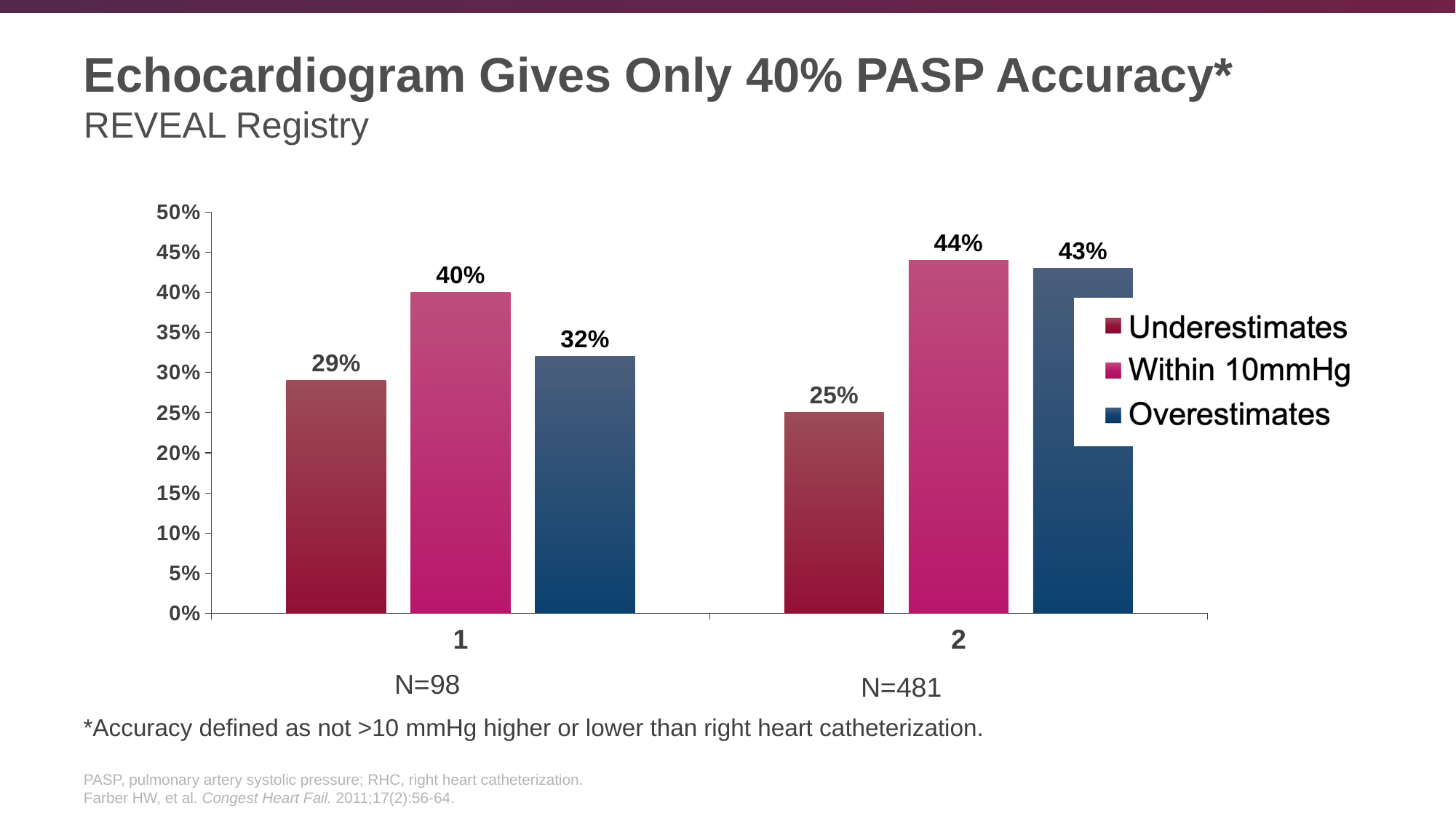
How many groups are shown on the x axis? 2 How many series does the legend list? 3 Which series has the lowest value in group 1 (N=98)? Underestimates What is the sample size (N) for group 2? N=481 Which series has the highest value in group 2 (N=481)? Within 10mmHg What is the value for Overestimates in group 1 (N=98)? 32% What is the difference between Within 10mmHg and Underestimates in group 2 (N=481)? 19% What is the value for Underestimates in group 2 (N=481)? 25% What kind of chart is shown on the slide? Bar chart Which is larger: Overestimates in group 1 or Overestimates in group 2? Overestimates in group 2 What is the value for Within 10mmHg in group 1 (N=98)? 40% Is the value for Underestimates in group 1 greater or less than 25%? greater